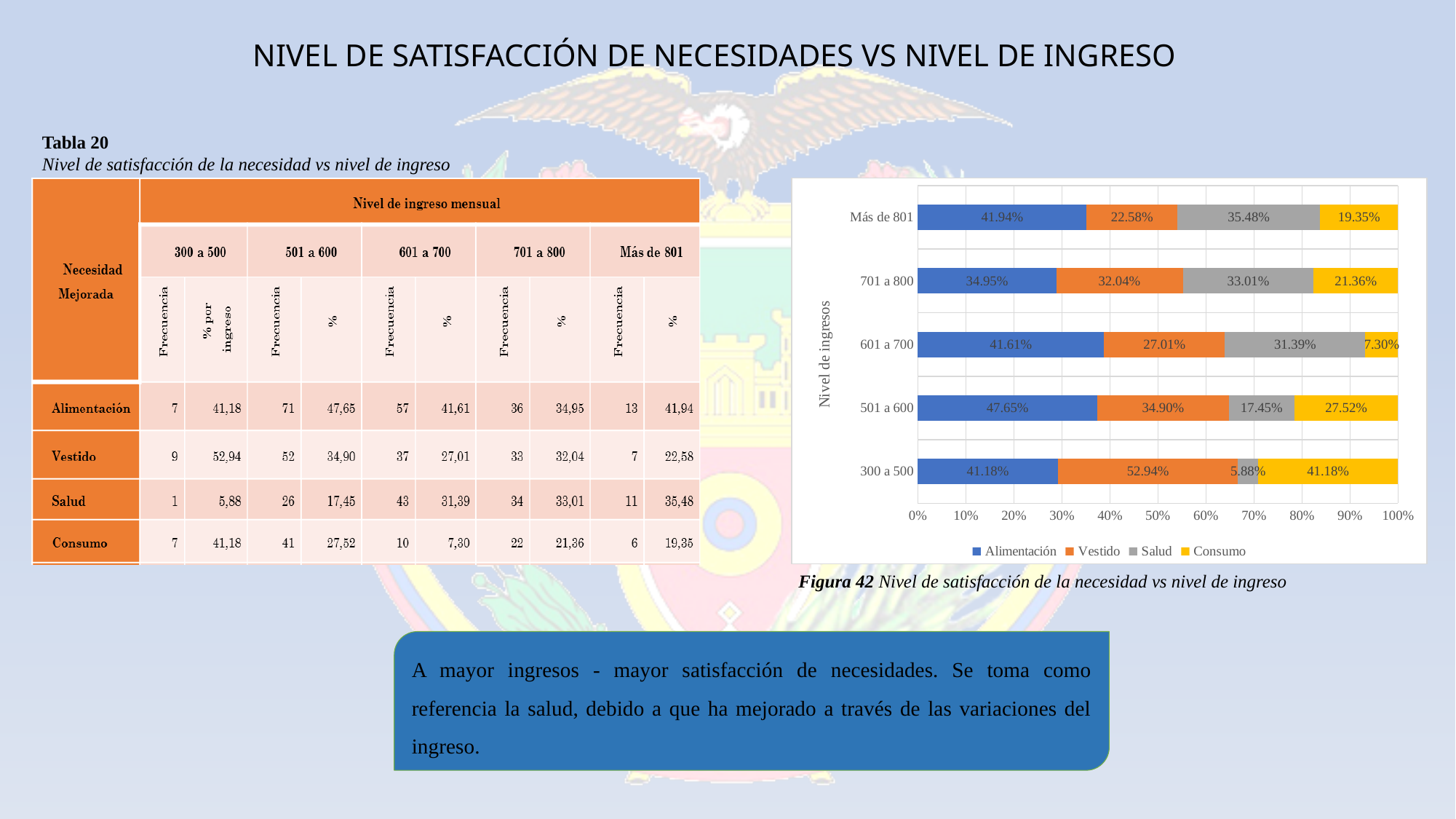
In the chart, what is the value for Salud in the 300 a 500 income level? 5.88% In the chart, what is the difference between the Alimentación and Vestido values for Más de 801? 19.36 percentage points In the chart, which income level has the lowest value for Salud? 300 a 500 In the chart, what is the value for Vestido in the 701 a 800 income level? 32.04% How many income levels are shown on the chart's vertical axis? 5 In the chart, what is the value for Consumo in the 601 a 700 income level? 7.30% In the chart, is the Salud value larger for 701 a 800 or for 601 a 700? 701 a 800 In the chart, what is the value for Alimentación in the 501 a 600 income level? 47.65% How many series does the chart's legend list? 4 In the chart, which income level has the highest value for Vestido? 300 a 500 In the chart, which income level has the highest value for Alimentación? 501 a 600 What kind of chart is shown on the slide? Stacked bar chart